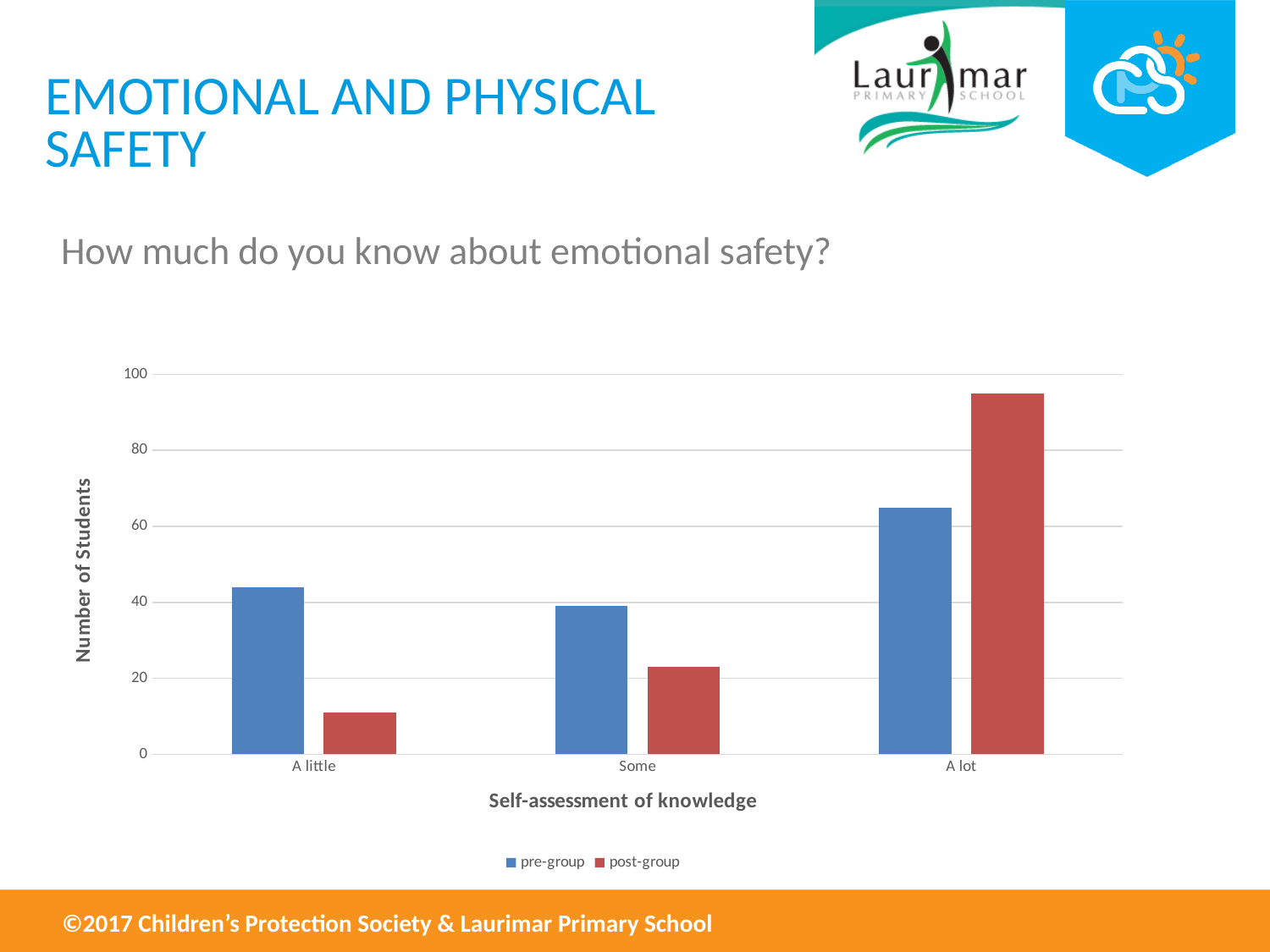
Which category has the highest post-group value? A lot Which category has the highest pre-group value? A lot How many categories are shown on the x axis of the chart? 3 For the A lot category, which is larger: the pre-group value or the post-group value? post-group For the A little category, which is larger: the pre-group value or the post-group value? pre-group What is the label of the chart's y axis? Number of Students Is the post-group value for A lot greater or less than 80? greater How many series does the chart legend list? 2 What kind of chart is shown on the slide? bar chart Which category has the lowest post-group value? A little Is the post-group value for A little greater or less than 20? less